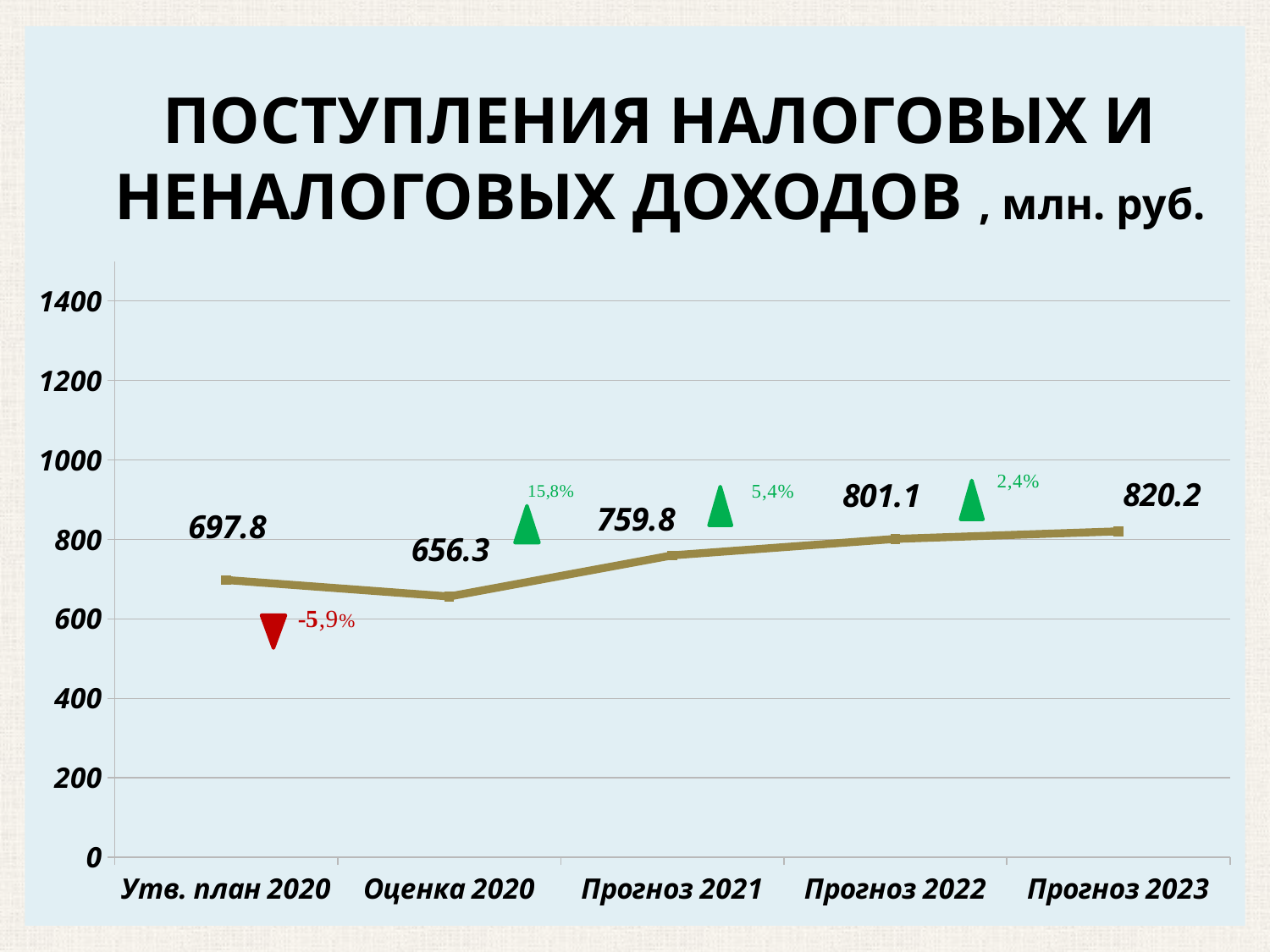
What is the difference between the values for Прогноз 2022 and Прогноз 2021? 41.3 What is the value for Оценка 2020? 656.3 What kind of chart is shown on the slide? line chart Is the value for Прогноз 2022 greater or less than 600? greater How many categories are plotted on the x axis? 5 What is the difference between the values for Утв. план 2020 and Оценка 2020? 41.5 What is the value for Прогноз 2023? 820.2 Which category has the highest value? Прогноз 2023 What is the value for Утв. план 2020? 697.8 What percentage change is shown between Оценка 2020 and Прогноз 2021? 15,8% Which is larger, the value for Утв. план 2020 or the value for Прогноз 2021? Прогноз 2021 Which category has the lowest value? Оценка 2020